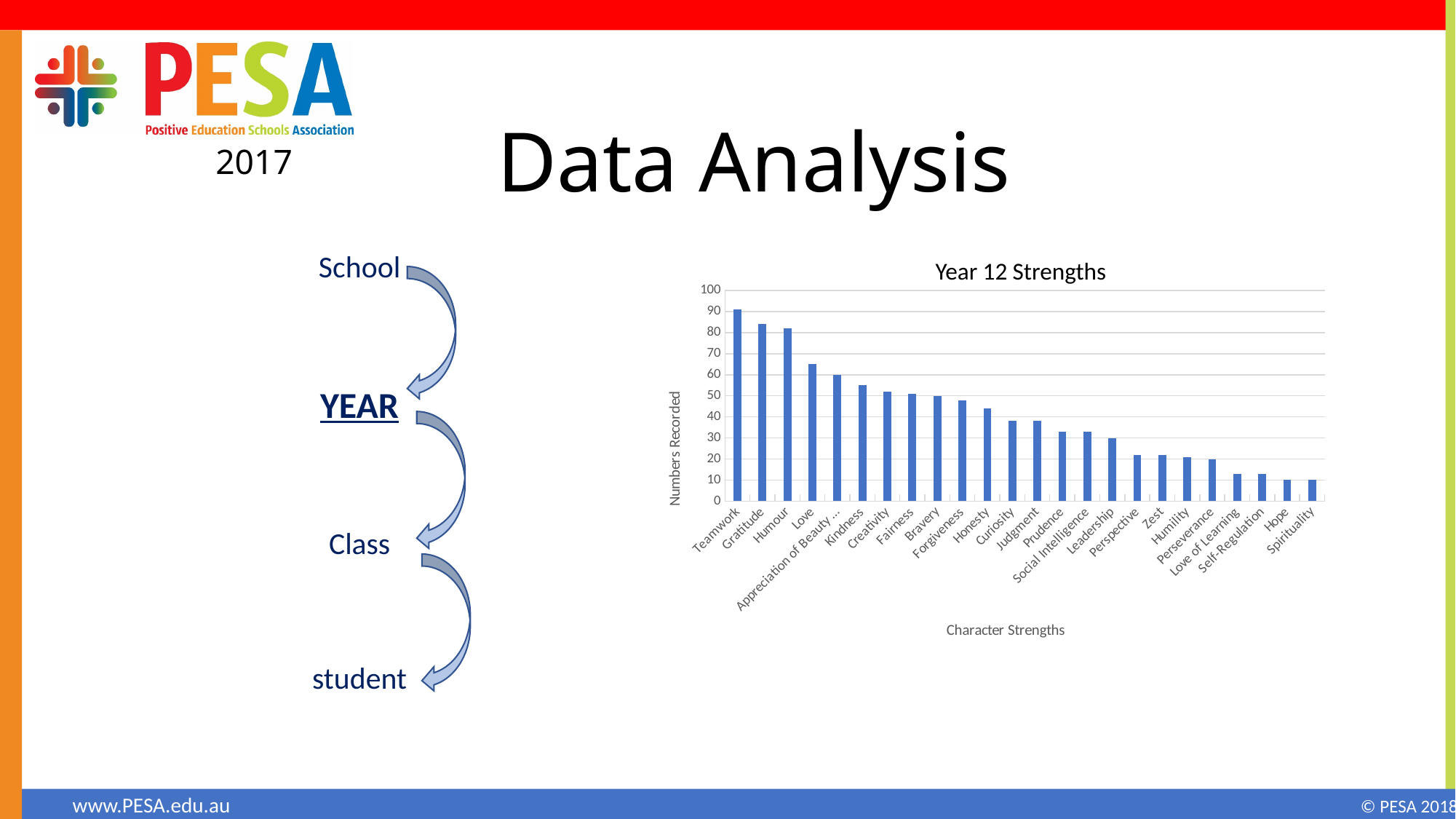
Is the value for Leadership greater or less than 40? less What is the title of the chart? Year 12 Strengths Which has a higher number recorded, Perseverance or Honesty? Honesty What is the label on the vertical axis of the chart? Numbers Recorded How many character strengths are plotted on the chart? 24 Which character strength has the highest number recorded? Teamwork Which has a higher number recorded, Gratitude or Kindness? Gratitude Is the value for Love greater or less than 60? greater Do the values rise or fall moving from left to right along the x axis? fall What kind of chart is shown on the slide? bar chart Is the value for Hope greater or less than 20? less